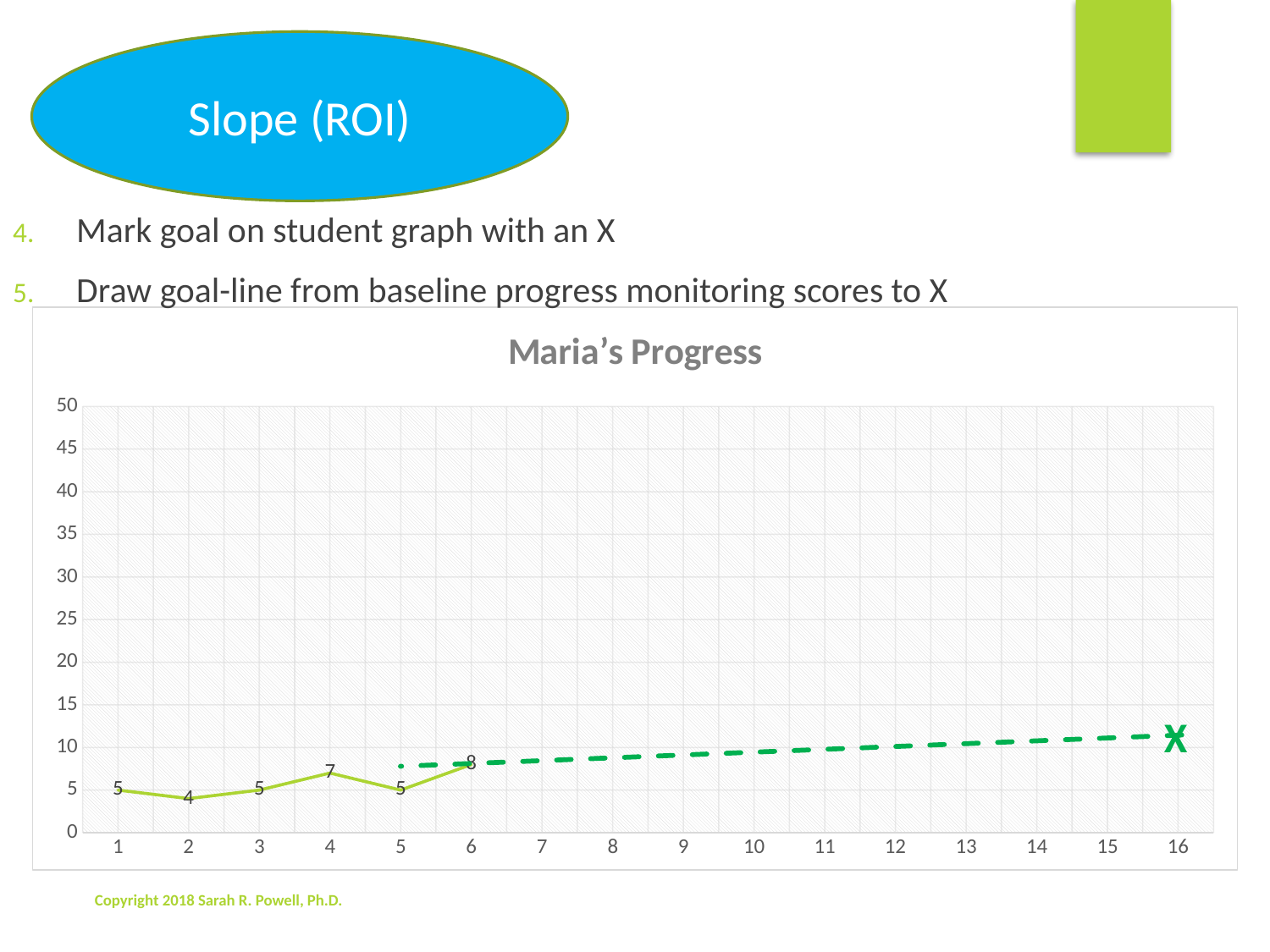
What is the difference between Maria's score at point 6 and her score at point 2? 4 What is Maria's score at point 4? 7 What is Maria's score at point 6? 8 What kind of chart is shown on the slide? line chart At which point is Maria's score lowest? 2 What is Maria's score at point 1? 5 Which is larger, Maria's score at point 4 or at point 5? point 4 At which point is Maria's score highest? 6 How many labeled data points are plotted on Maria's progress line? 6 What is Maria's score at point 2? 4 What is the title of the chart? Maria's Progress Is the goal marked with the X at point 16 greater or less than 15? less